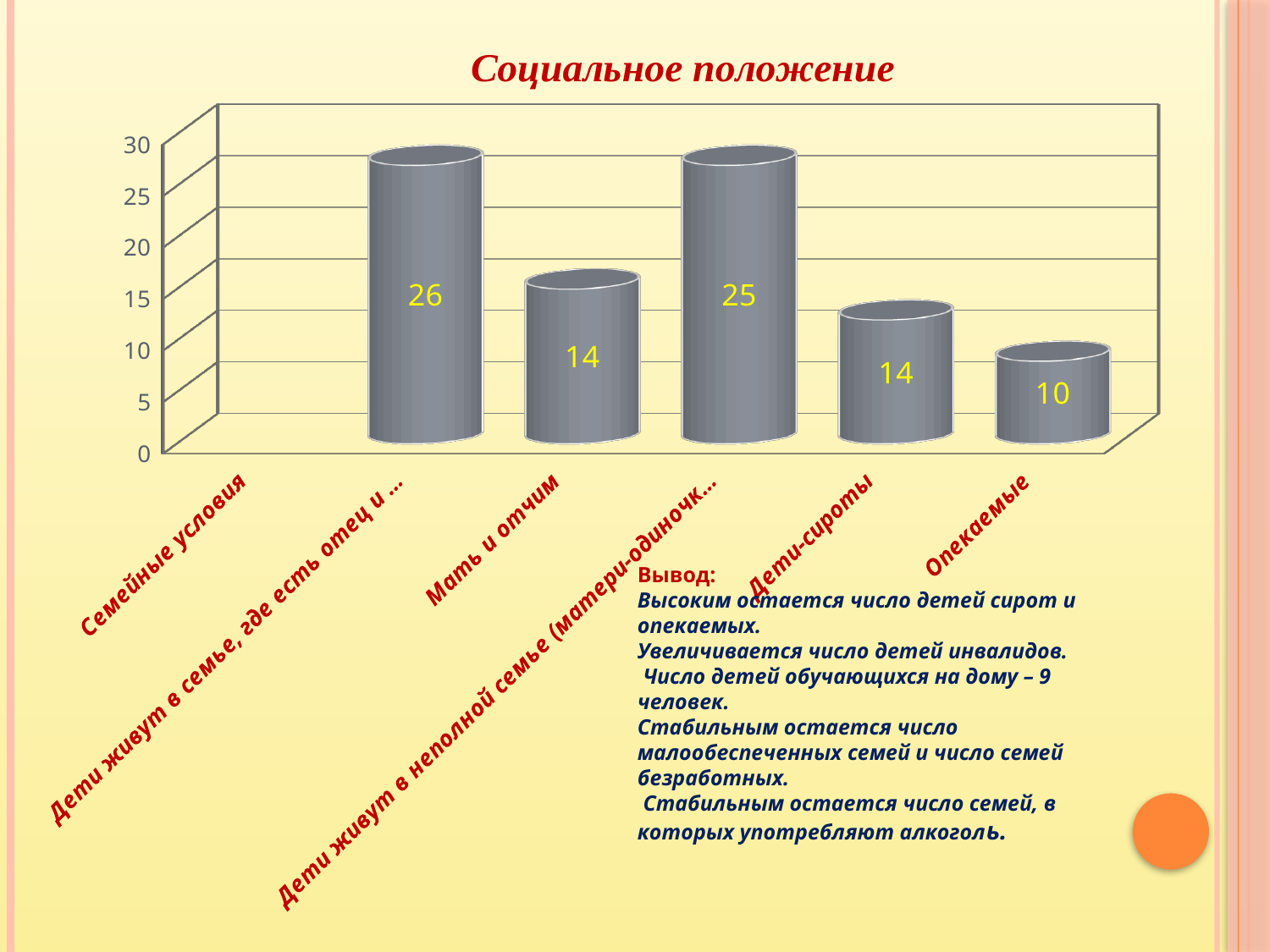
What is the value for Дети-сироты? 14 Is the value for Опекаемые greater or less than 15? less What kind of chart is shown on the slide? bar chart Which is larger, the value for Мать и отчим or the value for Опекаемые? Мать и отчим Which category has the highest value? Дети живут в семье, где есть отец и ... What is the value for Мать и отчим? 14 Which category has the lowest value? Опекаемые What is the value for the category 'Дети живут в семье, где есть отец и ...'? 26 What is the value for Опекаемые? 10 How many bars are plotted in the chart? 5 What is the title of the chart? Социальное положение What is the difference between the values for Дети-сироты and Опекаемые? 4